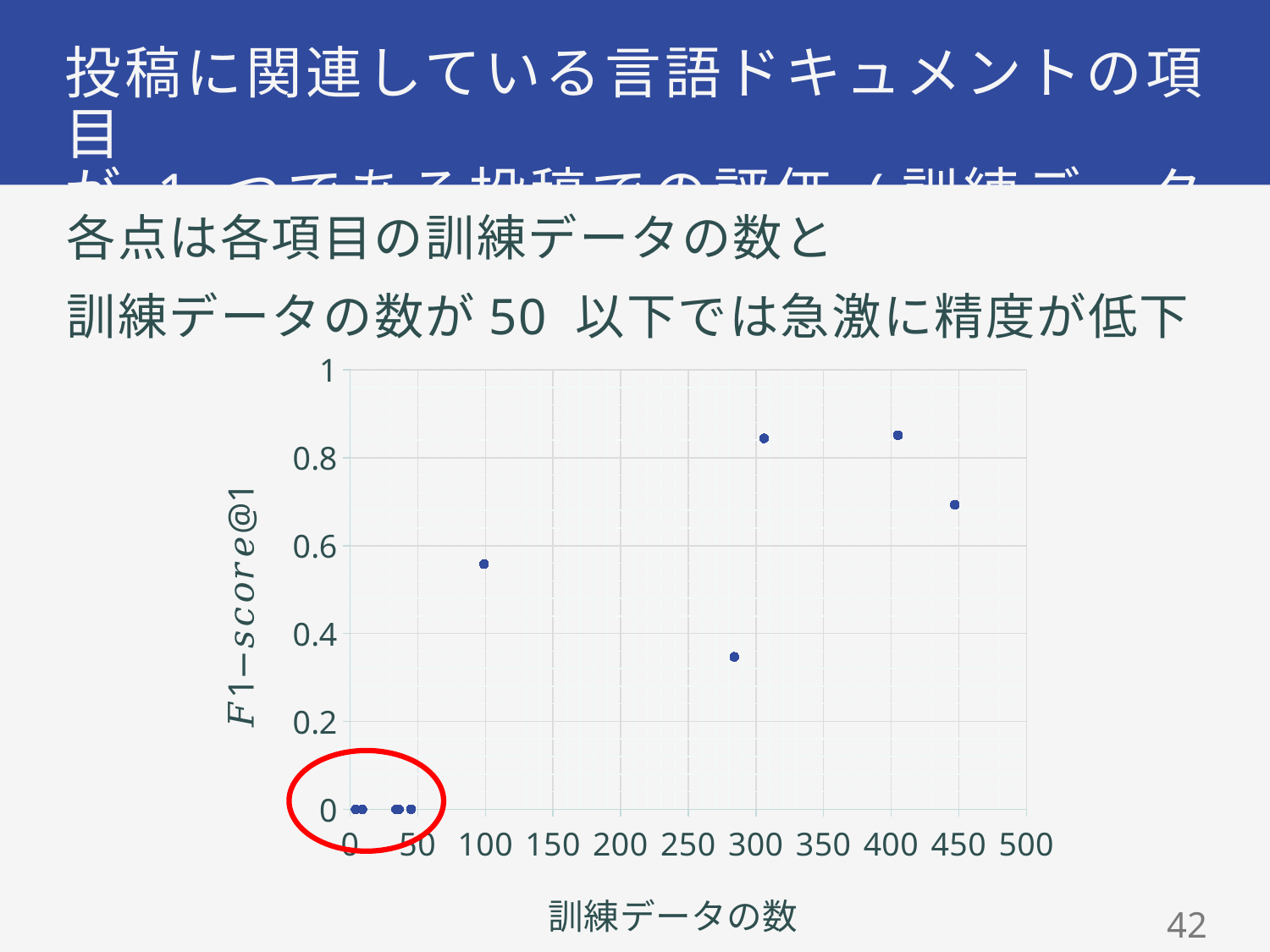
How many points have an F1-score@1 above 0.8? 2 What is the maximum value shown on the x axis? 500 Is the F1-score@1 of the point at about 445 training examples greater or less than 0.6? greater How many points have an F1-score@1 above 0.5? 4 What is the label of the y axis of the chart? F1-score@1 What kind of chart is shown on the slide? scatter chart Is the F1-score@1 of the point at about 305 training examples greater or less than 0.8? greater Is the F1-score@1 of the point at about 285 training examples greater or less than 0.4? less Which point has the higher F1-score@1: the one at about 100 training examples or the one at about 285 training examples? the one at about 100 training examples What F1-score@1 value do the points inside the red circle have? 0 What is the label of the x axis of the chart? 訓練データの数